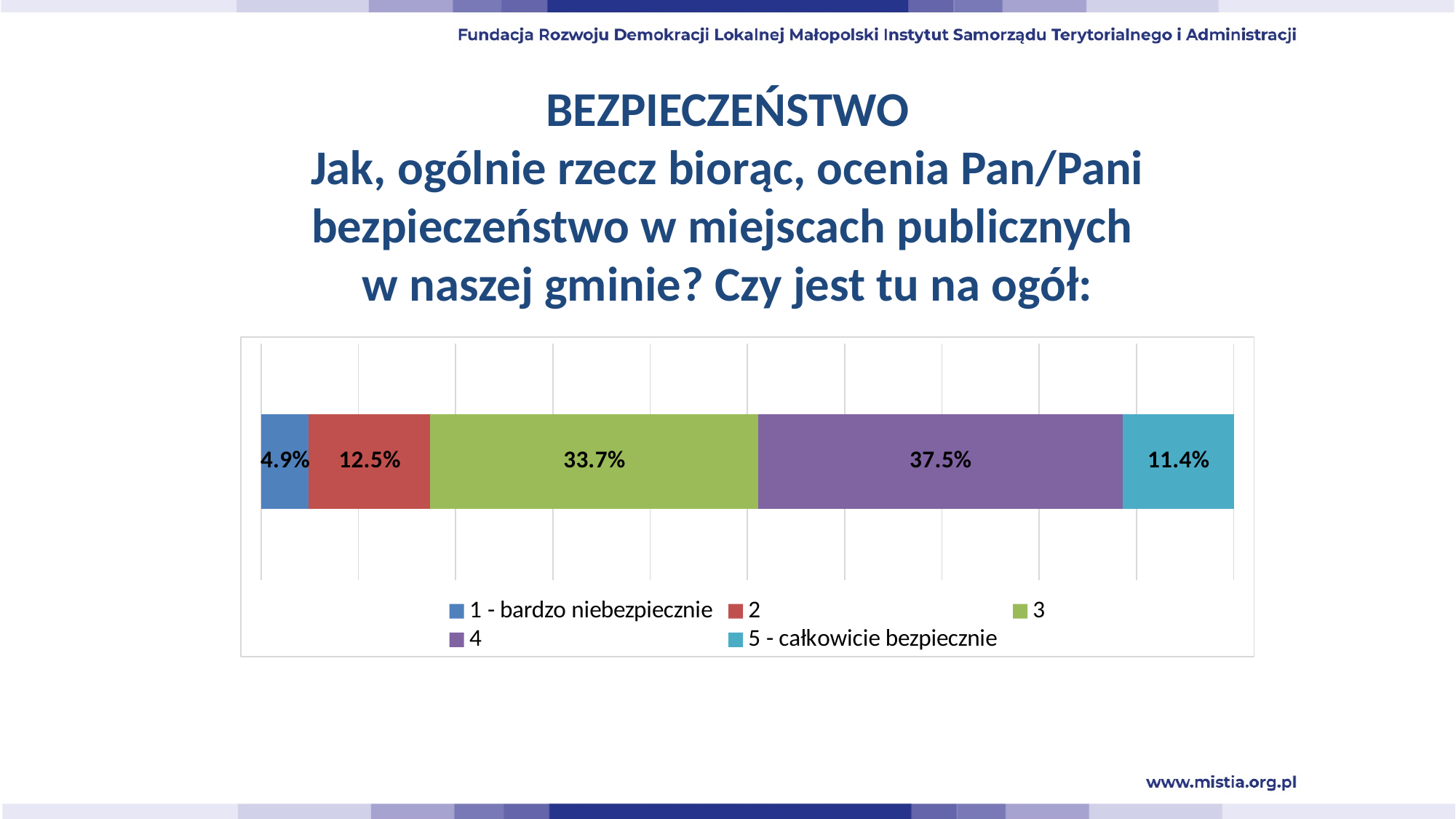
What percentage of respondents chose rating "4"? 37.5% How many series does the legend list? 5 What percentage of respondents chose rating "2"? 12.5% Which rating has the largest share of respondents? 4 What percentage of respondents chose rating "3"? 33.7% Which is larger: the share for rating "2" or the share for "5 - całkowicie bezpiecznie"? 2 What kind of chart is shown on the slide? Stacked bar chart What is the difference between the shares for rating "4" and rating "3"? 3.8% Which rating has the smallest share of respondents? 1 - bardzo niebezpiecznie What percentage of respondents chose "5 - całkowicie bezpiecznie"? 11.4% What is the total of all segments in the stacked bar? 100.0% What percentage of respondents chose "1 - bardzo niebezpiecznie"? 4.9%